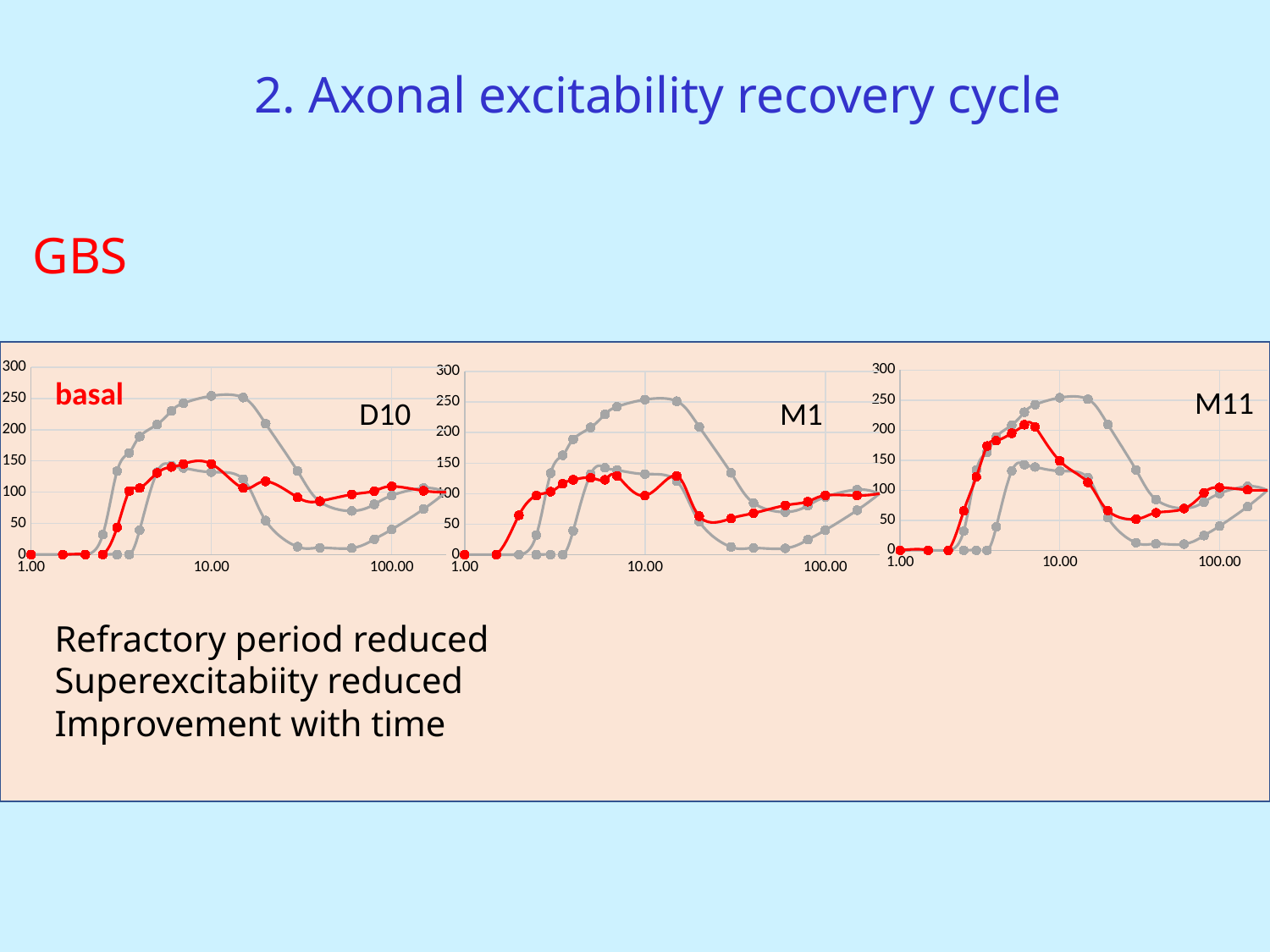
In the M11 chart, which line reaches a higher peak, the red line or the upper grey line? the upper grey line What is the highest value shown on the y axis of the M1 chart? 300 How many charts are shown on the slide? 3 In the D10 chart, is the peak value of the upper grey line greater or less than 200? greater In the D10 chart, is the value of the red line at x = 100.00 greater or less than 50? greater In the M1 chart, is the peak value of the red line greater or less than 200? less What are the labels of the three charts, from left to right? D10, M1, M11 In the D10 chart, does the red line rise or fall between x = 1.00 and x = 10.00? rise What kind of chart is the D10 chart? line chart